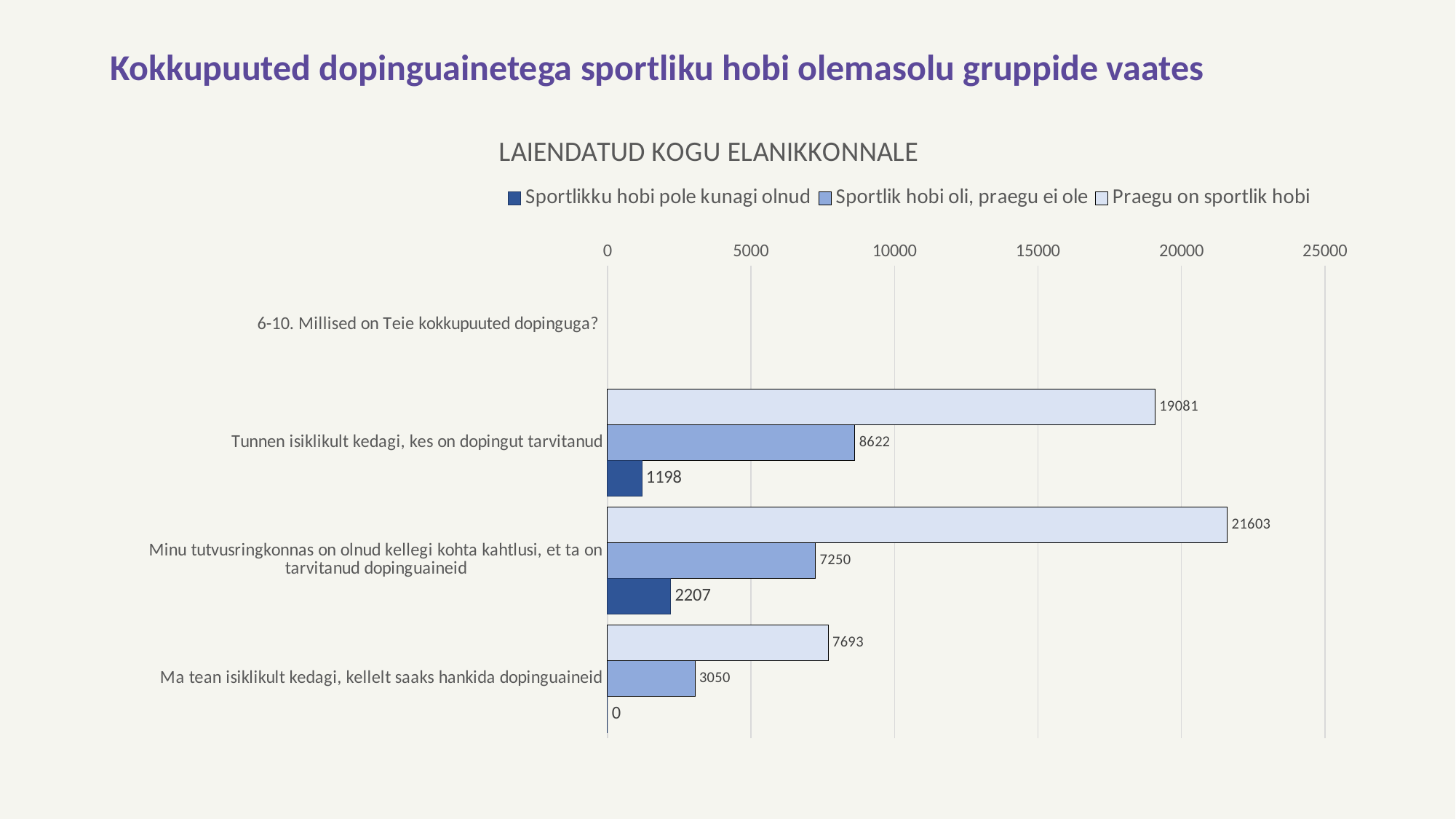
What is the value for 'Sportlik hobi oli, praegu ei ole' in the category 'Ma tean isiklikult kedagi, kellelt saaks hankida dopinguaineid'? 3050 Which is larger: the 'Sportlik hobi oli, praegu ei ole' value for 'Tunnen isiklikult kedagi, kes on dopingut tarvitanud' or for 'Minu tutvusringkonnas on olnud kellegi kohta kahtlusi, et ta on tarvitanud dopinguaineid'? Tunnen isiklikult kedagi, kes on dopingut tarvitanud Is the 'Praegu on sportlik hobi' value for 'Ma tean isiklikult kedagi, kellelt saaks hankida dopinguaineid' greater or less than 10000? less How many series does the legend list? 3 What is the difference between the 'Praegu on sportlik hobi' values for 'Minu tutvusringkonnas on olnud kellegi kohta kahtlusi, et ta on tarvitanud dopinguaineid' and 'Tunnen isiklikult kedagi, kes on dopingut tarvitanud'? 2522 Which category has the highest value for 'Praegu on sportlik hobi'? Minu tutvusringkonnas on olnud kellegi kohta kahtlusi, et ta on tarvitanud dopinguaineid What is the value for 'Praegu on sportlik hobi' in the category 'Tunnen isiklikult kedagi, kes on dopingut tarvitanud'? 19081 What is the value for 'Sportlikku hobi pole kunagi olnud' in the category 'Ma tean isiklikult kedagi, kellelt saaks hankida dopinguaineid'? 0 Which category has the lowest value for 'Sportlik hobi oli, praegu ei ole'? Ma tean isiklikult kedagi, kellelt saaks hankida dopinguaineid What kind of chart is shown on the slide? bar chart What is the value for 'Sportlikku hobi pole kunagi olnud' in the category 'Minu tutvusringkonnas on olnud kellegi kohta kahtlusi, et ta on tarvitanud dopinguaineid'? 2207 What is the title of the chart? LAIENDATUD KOGU ELANIKKONNALE